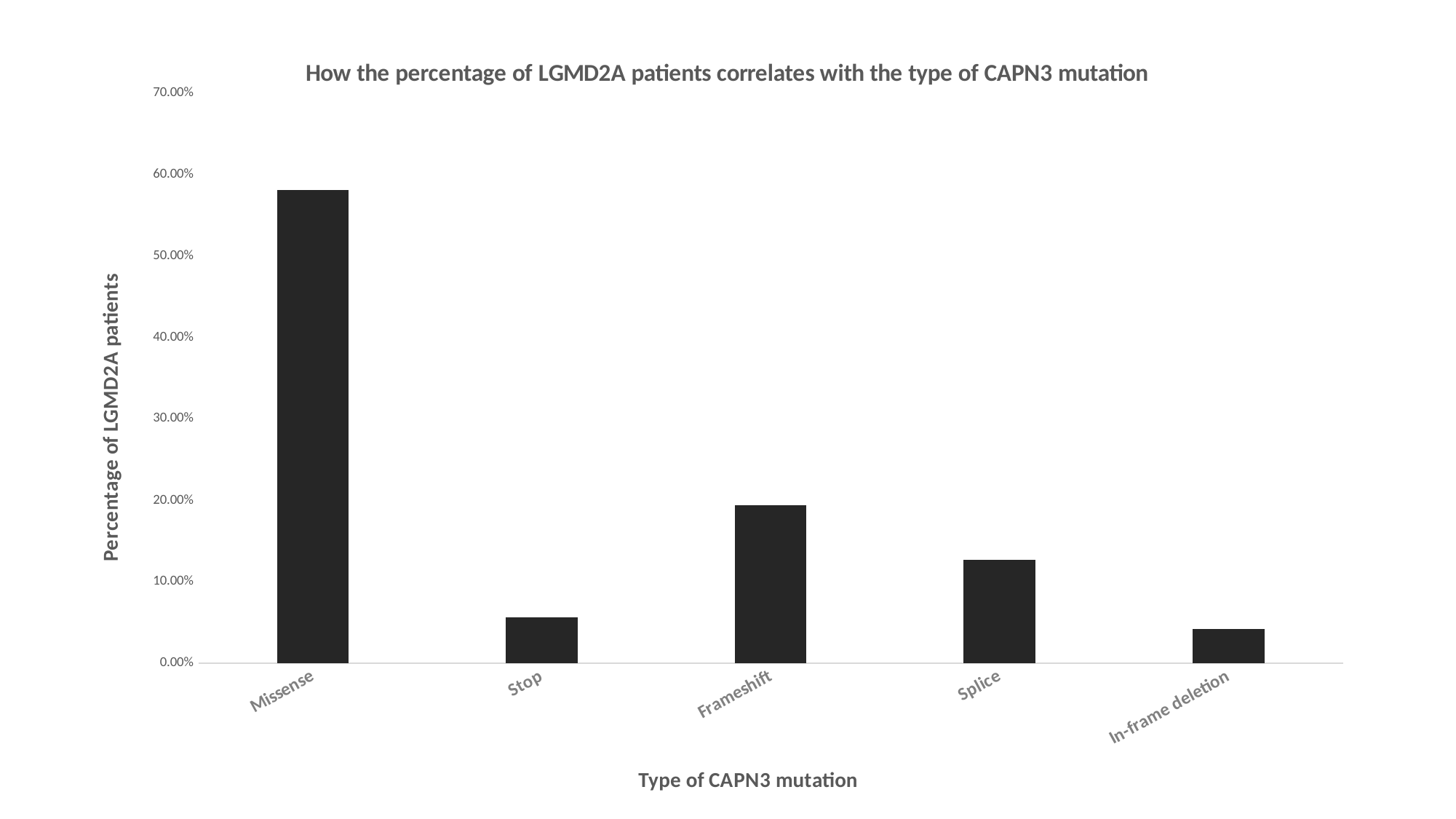
Is the percentage of LGMD2A patients for Splice greater or less than 10.00%? greater Is the percentage of LGMD2A patients for Frameshift greater or less than 20.00%? less What kind of chart is shown on the slide? bar chart Which has a higher percentage of LGMD2A patients, Frameshift or Splice? Frameshift How many types of CAPN3 mutation are shown on the x axis? 5 What is the title of the chart? How the percentage of LGMD2A patients correlates with the type of CAPN3 mutation Is the percentage of LGMD2A patients for Missense greater or less than 60.00%? less Which type of CAPN3 mutation has the highest percentage of LGMD2A patients? Missense Which type of CAPN3 mutation has the lowest percentage of LGMD2A patients? In-frame deletion What is the label of the y axis? Percentage of LGMD2A patients